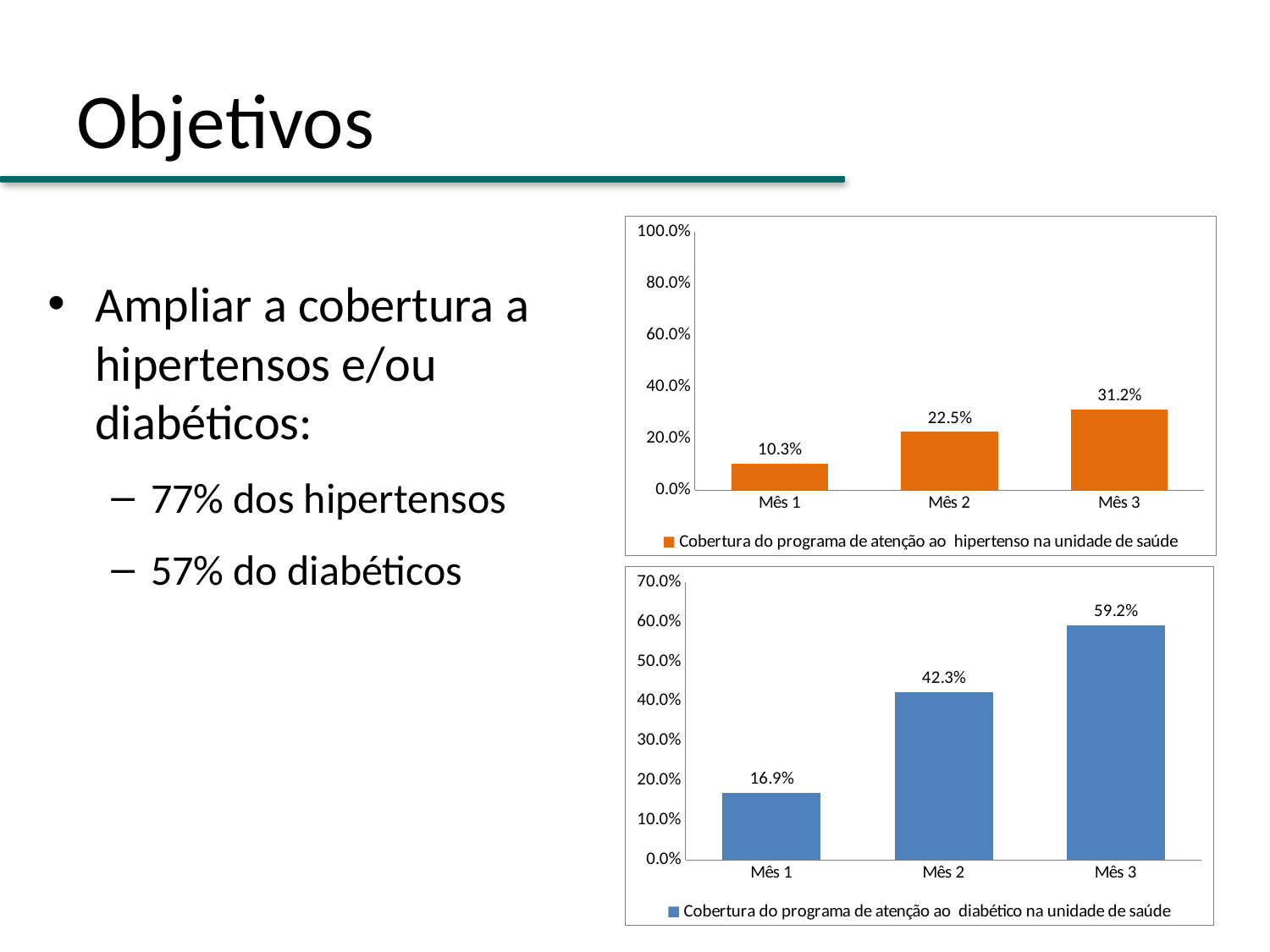
In the top chart (hipertenso), what is the difference between the values for Mês 3 and Mês 1? 20.9% In the bottom chart (diabético), which is larger, the value for Mês 2 or Mês 3? Mês 3 What kind of chart is the bottom chart (diabético)? Bar chart In the bottom chart (diabético), what is the difference between the values for Mês 2 and Mês 1? 25.4% In the bottom chart (Cobertura do programa de atenção ao diabético na unidade de saúde), what is the value for Mês 3? 59.2% In the bottom chart (diabético), which month has the lowest value? Mês 1 In the top chart (hipertenso), is the value for Mês 3 greater or less than 40.0%? less In the top chart (Cobertura do programa de atenção ao hipertenso na unidade de saúde), what is the value for Mês 2? 22.5% How many series does the legend of the top chart (hipertenso) list? 1 How many months are shown on the x axis of the bottom chart (diabético)? 3 In the top chart (hipertenso), which month has the highest value? Mês 3 In the top chart (hipertenso), do the values rise or fall from Mês 1 to Mês 3? Rise